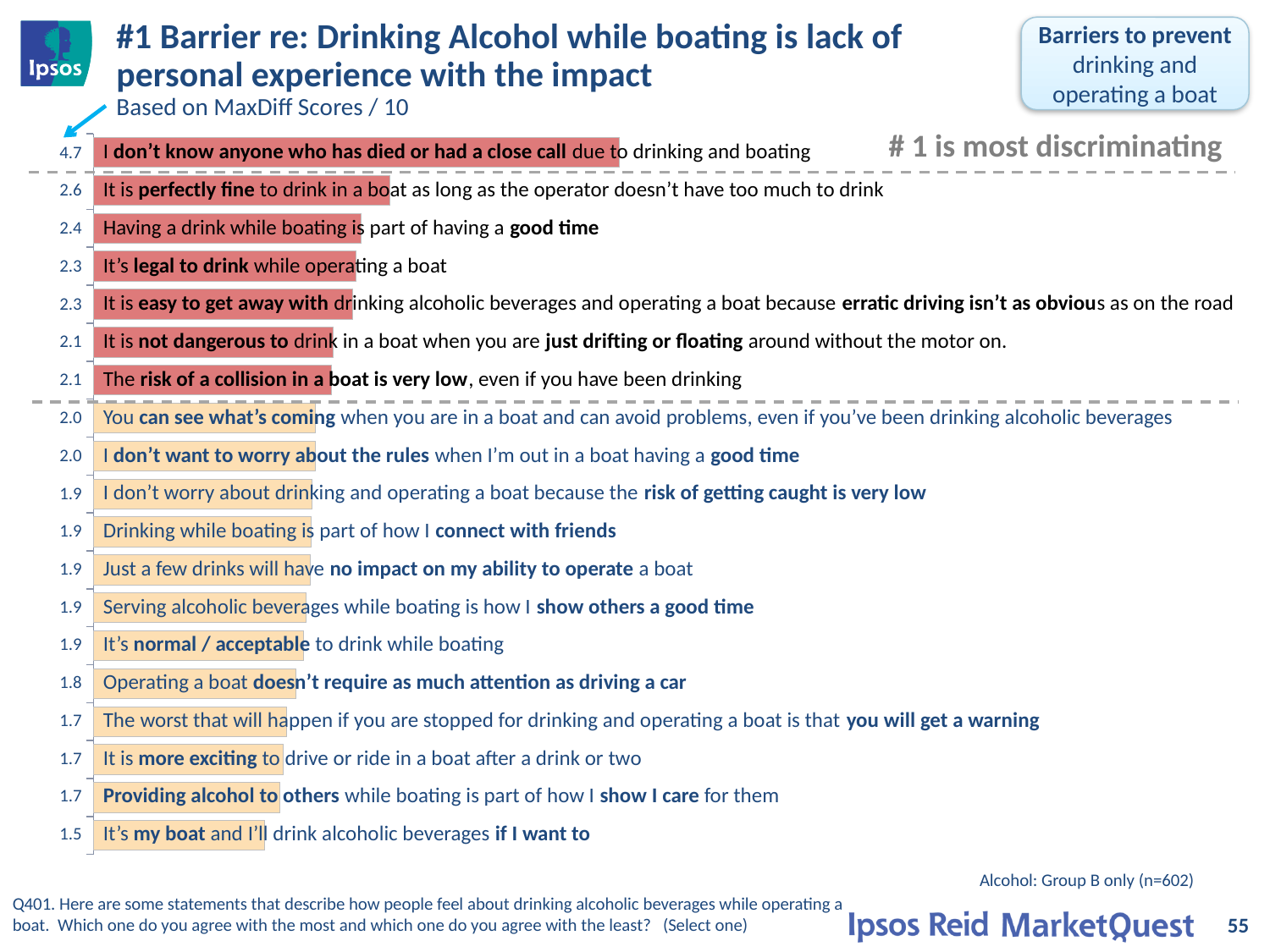
Which has a higher MaxDiff score: "It is perfectly fine to drink in a boat as long as the operator doesn't have too much to drink" or "Having a drink while boating is part of having a good time"? It is perfectly fine to drink in a boat as long as the operator doesn't have too much to drink What is the MaxDiff score for "The worst that will happen if you are stopped for drinking and operating a boat is that you will get a warning"? 1.7 What kind of chart is shown on the slide? Bar chart What is the MaxDiff score for "It's my boat and I'll drink alcoholic beverages if I want to"? 1.5 What is the difference between the highest MaxDiff score (4.7) and the second highest (2.6)? 2.1 How many statements are plotted in the chart? 19 What is the MaxDiff score for "Operating a boat doesn't require as much attention as driving a car"? 1.8 What is the MaxDiff score for "It's legal to drink while operating a boat"? 2.3 What is the sample size noted for the Alcohol Group B on the slide? n=602 Which statement has the lowest MaxDiff score? It's my boat and I'll drink alcoholic beverages if I want to What is the MaxDiff score for the statement "I don't know anyone who has died or had a close call due to drinking and boating"? 4.7 Which statement has the highest MaxDiff score? I don't know anyone who has died or had a close call due to drinking and boating